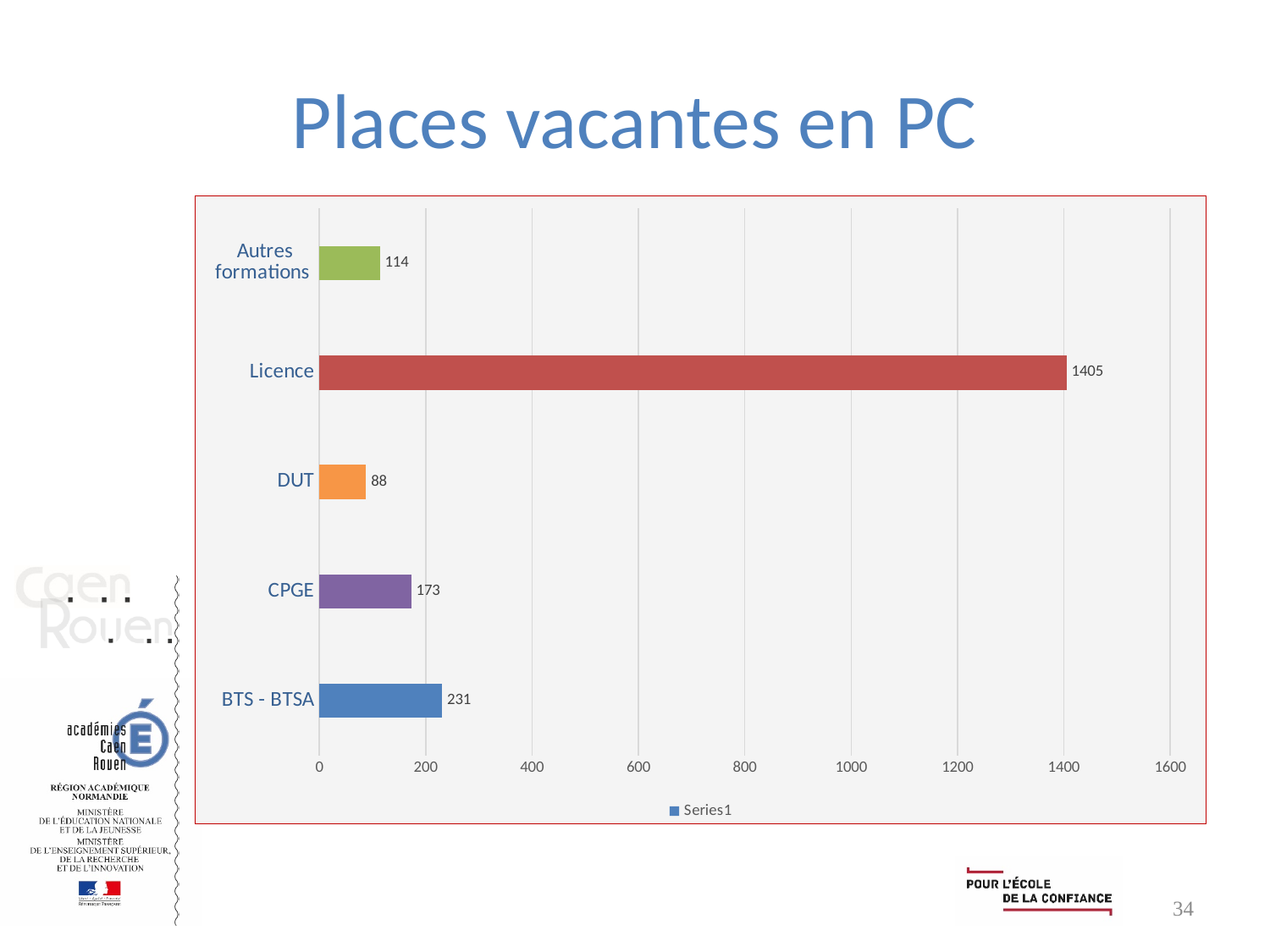
What is the value for Autres formations? 114 What is the value for DUT? 88 What kind of chart is shown on the slide? bar chart Which category has the lowest value? DUT Which category has the highest value? Licence What is the value for BTS - BTSA? 231 What is the value for Licence? 1405 How many categories are shown in the chart? 5 Which is larger, the value for CPGE or the value for Autres formations? CPGE Is the value for Licence greater or less than 1200? greater What is the difference between the values for BTS - BTSA and CPGE? 58 What is the title of the slide? Places vacantes en PC